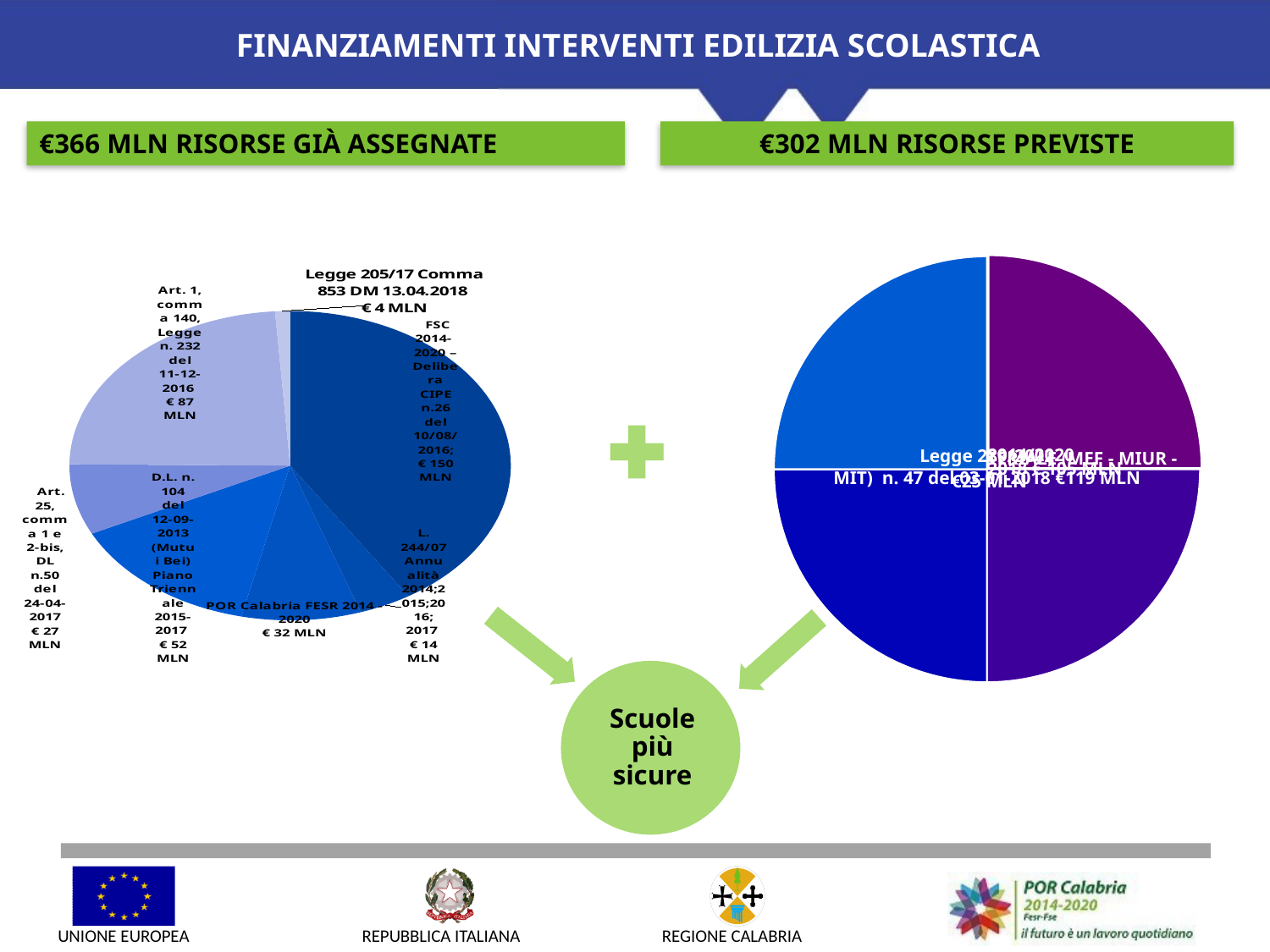
In the left pie chart (€366 MLN risorse già assegnate), what is the value for 'POR Calabria FESR 2014-2020'? € 32 MLN In the left pie chart (€366 MLN risorse già assegnate), what is the value for 'Art. 1, comma 140, Legge n. 232 del 11-12-2016'? € 87 MLN In the left pie chart (€366 MLN risorse già assegnate), which funding source has the smallest slice? Legge 205/17 Comma 853 DM 13.04.2018 (€ 4 MLN) In the left pie chart (€366 MLN risorse già assegnate), what is the difference between the FSC 2014-2020 value and the Art. 1, comma 140, Legge n. 232 value? € 63 MLN How many slices does the right pie chart (€302 MLN risorse previste) have? 4 In the left pie chart (€366 MLN risorse già assegnate), what is the value for 'D.L. n. 104 del 12-09-2013 (Mutui Bei) Piano Triennale 2015-2017'? € 52 MLN In the left pie chart (€366 MLN risorse già assegnate), what is the value for 'FSC 2014-2020 – Delibera CIPE n.26 del 10/08/2016'? € 150 MLN How many slices does the left pie chart (€366 MLN risorse già assegnate) have? 7 In the left pie chart (€366 MLN risorse già assegnate), which is larger: 'D.L. n. 104 del 12-09-2013 (Mutui Bei)' or 'Art. 25, comma 1 e 2-bis, DL n.50 del 24-04-2017'? D.L. n. 104 del 12-09-2013 (Mutui Bei) In the left pie chart (€366 MLN risorse già assegnate), which funding source has the largest slice? FSC 2014-2020 – Delibera CIPE n.26 del 10/08/2016 (€ 150 MLN) What type of chart is used on the left side of the slide under '€366 MLN RISORSE GIÀ ASSEGNATE'? Pie chart In the left pie chart (€366 MLN risorse già assegnate), what is the value for 'Legge 205/17 Comma 853 DM 13.04.2018'? € 4 MLN